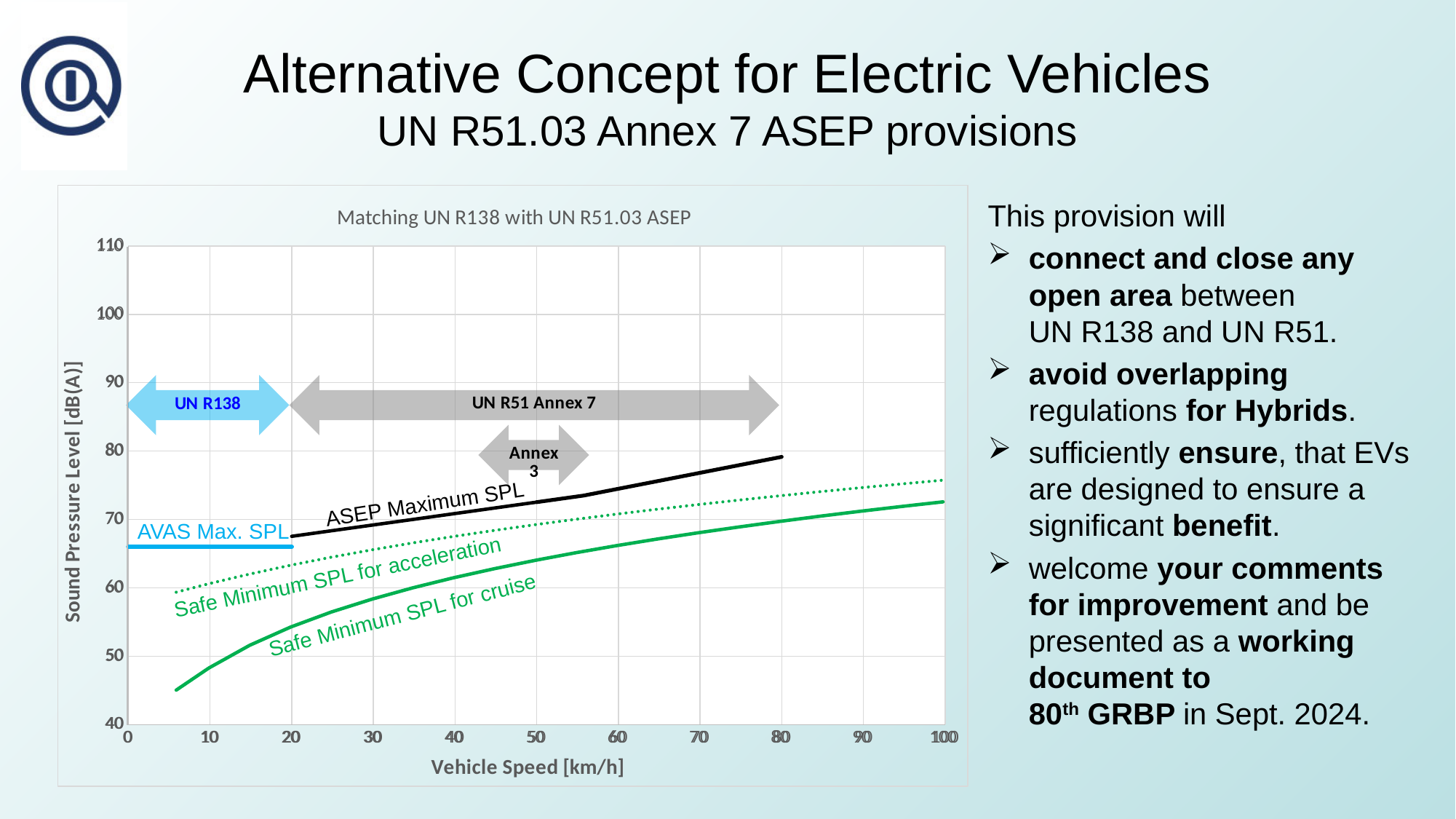
At 50 km/h, which line is higher: ASEP Maximum SPL or Safe Minimum SPL for cruise? ASEP Maximum SPL Is the AVAS Max. SPL level greater or less than 70? less How many labelled lines are plotted on the chart? 4 What is the label of the y axis of the chart? Sound Pressure Level [dB(A)] Does the Safe Minimum SPL for cruise line rise or fall as vehicle speed increases? rise What kind of chart is shown on the slide? line chart What is the title of the chart? Matching UN R138 with UN R51.03 ASEP Does the ASEP Maximum SPL line rise or fall as vehicle speed increases? rise Is the value of the Safe Minimum SPL for cruise line at 10 km/h greater or less than 60? less Is the value of the Safe Minimum SPL for cruise line at 100 km/h greater or less than 60? greater At 40 km/h, which line is higher: Safe Minimum SPL for acceleration or Safe Minimum SPL for cruise? Safe Minimum SPL for acceleration